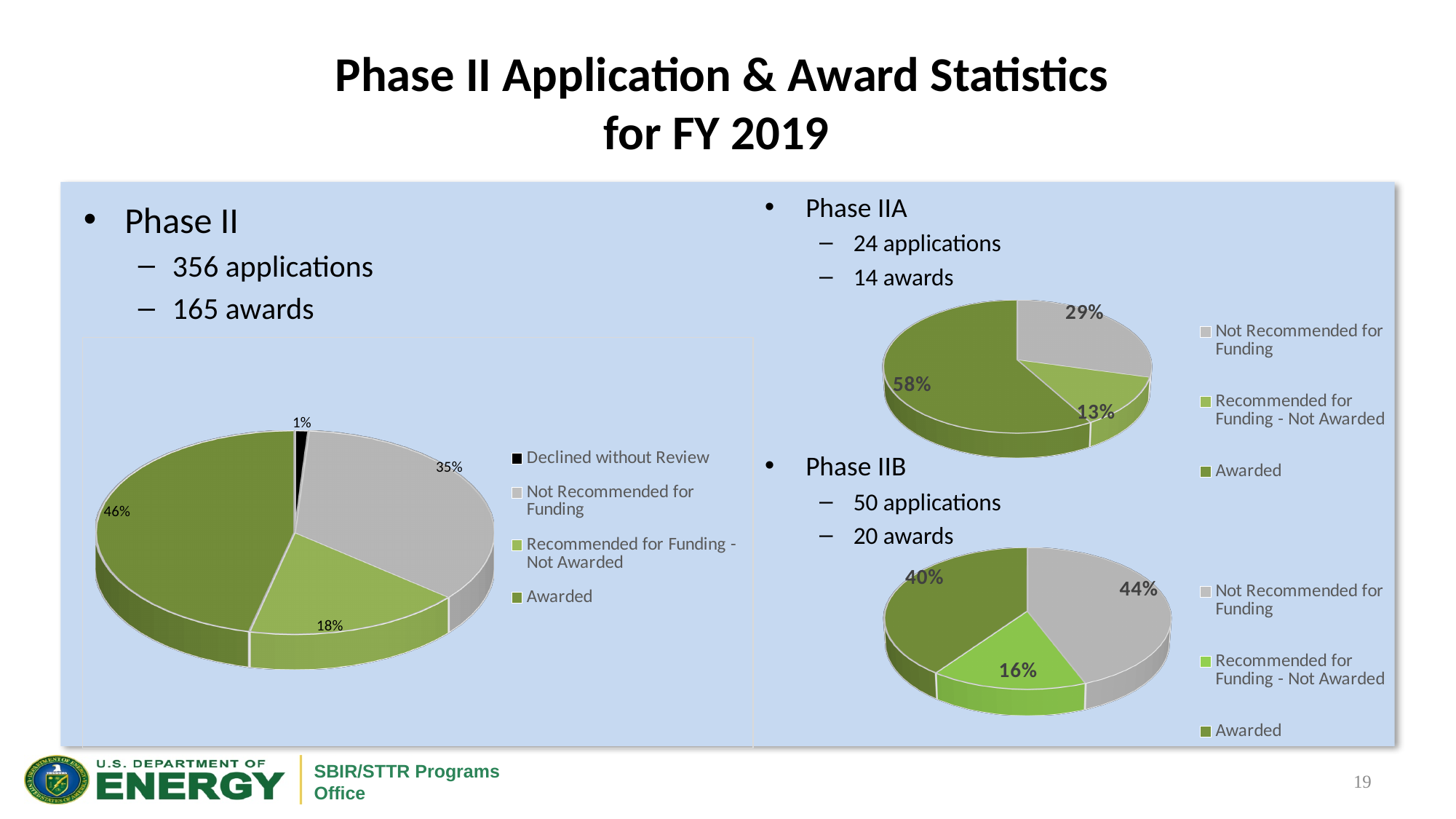
In the Phase IIB pie chart, which is larger: Not Recommended for Funding or Awarded? Not Recommended for Funding In the Phase IIB pie chart, what share is Not Recommended for Funding? 44% What type of chart is used for the Phase IIA data? Pie chart In the Phase II pie chart on the left, what share is Awarded? 46% In the Phase IIA pie chart, which category has the smallest slice? Recommended for Funding - Not Awarded In the Phase II pie chart on the left, what share is Declined without Review? 1% In the Phase II pie chart on the left, which category has the smallest slice? Declined without Review In the Phase IIB pie chart, how many entries does the legend list? 3 In the Phase II pie chart on the left, what is the difference between the Not Recommended for Funding share and the Recommended for Funding - Not Awarded share? 17% In the Phase II pie chart on the left, which category has the largest slice? Awarded In the Phase II pie chart on the left, how many slices does the pie have? 4